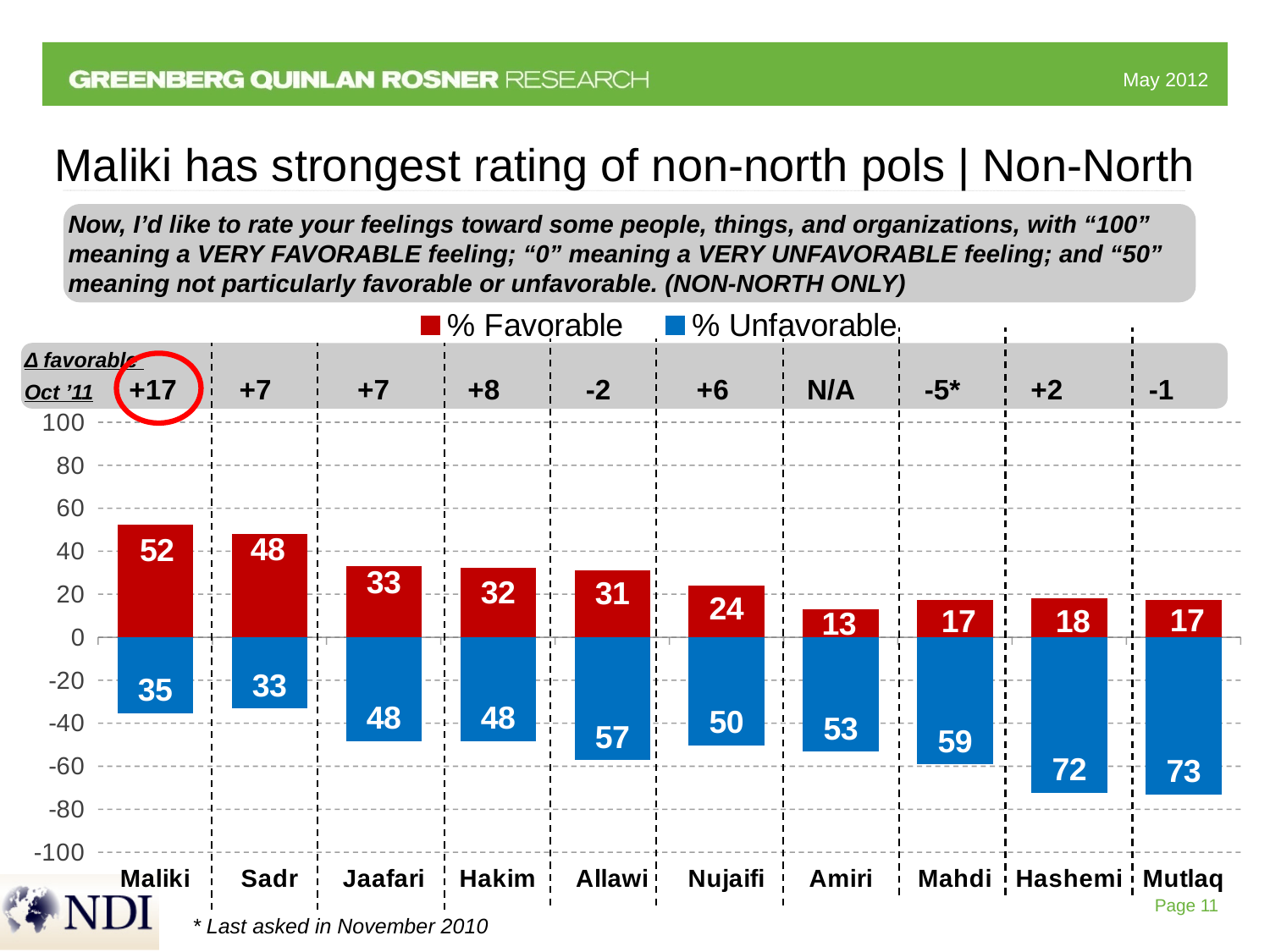
Which politician has the lowest % Unfavorable value? Sadr What is the % Unfavorable value for Hashemi? 72 How many series does the chart's legend list? 2 Which is larger, the % Unfavorable value for Allawi or for Nujaifi? Allawi What is the difference between Maliki's % Favorable and % Unfavorable values? 17 What kind of chart is shown on the slide? Bar chart Which politician has the highest % Favorable value? Maliki Which politician has the highest % Unfavorable value? Mutlaq What is the % Favorable value for Maliki? 52 What is the % Favorable value for Nujaifi? 24 How many politicians are shown on the x axis of the chart? 10 Which politician has the lowest % Favorable value? Amiri